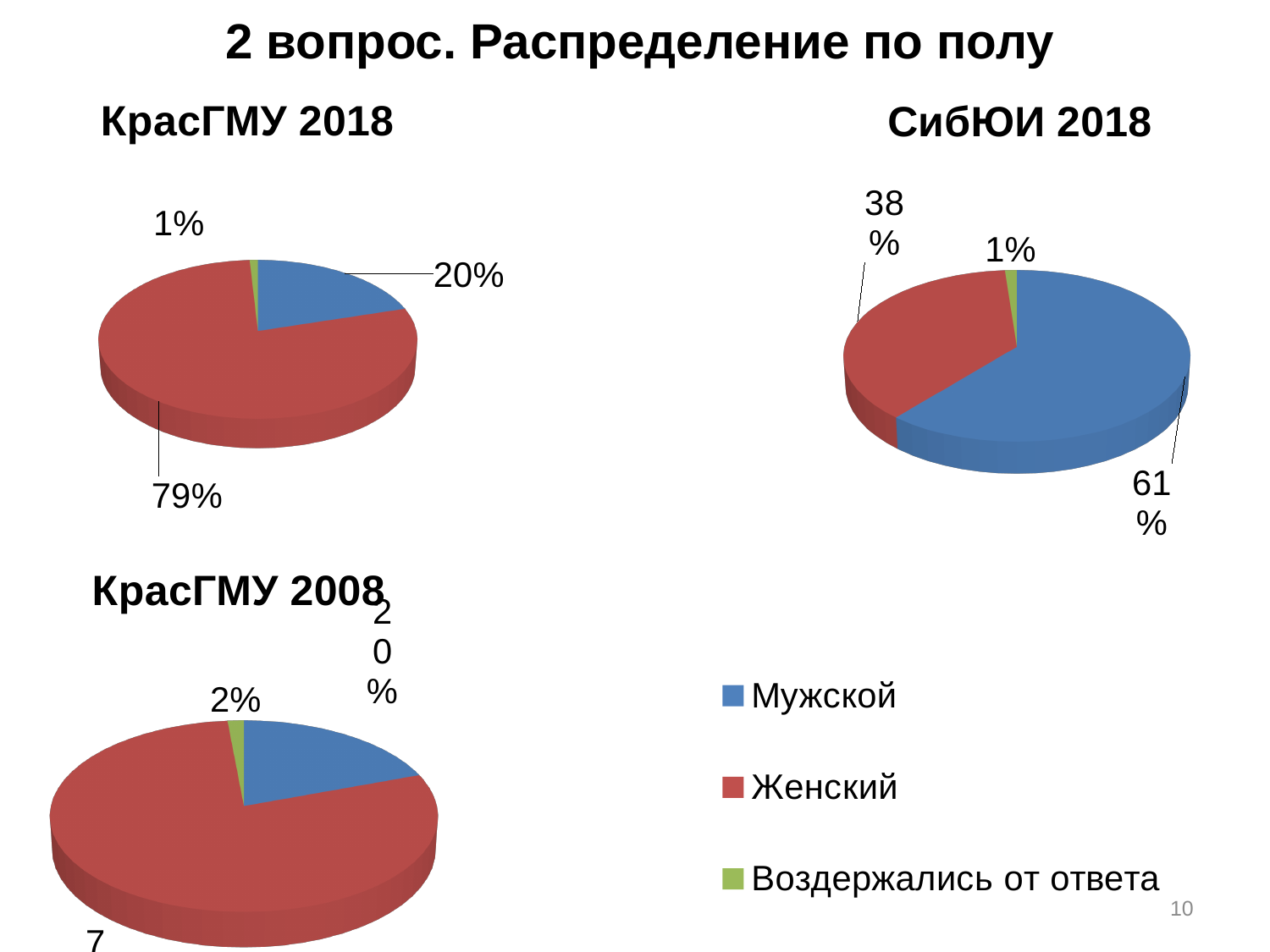
How many categories does the legend list? 3 In the КрасГМУ 2018 chart, which is larger, Мужской or Женский? Женский In the СибЮИ 2018 chart, what share is Мужской? 61% In the КрасГМУ 2018 chart, what share is Женский? 79% In the СибЮИ 2018 chart, which category has the largest slice? Мужской In the КрасГМУ 2018 chart, which category has the smallest slice? Воздержались от ответа What kind of chart is the СибЮИ 2018 chart? Pie chart In the КрасГМУ 2008 chart, what share is Воздержались от ответа? 2% In the СибЮИ 2018 chart, what is the difference between the Мужской and Женский shares? 23% In the СибЮИ 2018 chart, what share is Женский? 38% Which colour represents Женский in the charts? Red In the КрасГМУ 2018 chart, what share is Мужской? 20%